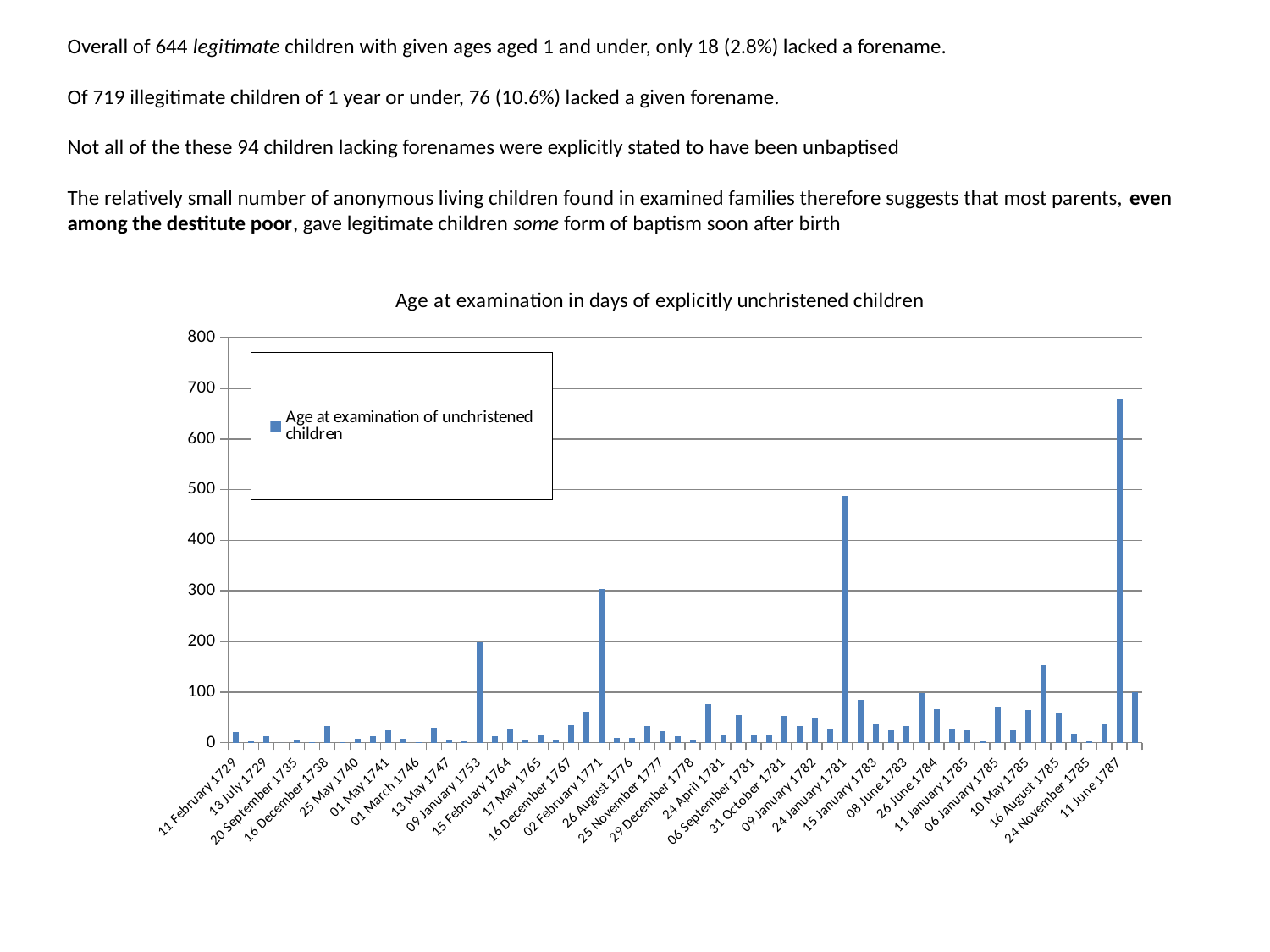
Is the value of the tallest bar in the chart greater or less than 600? greater What is the title of the chart? Age at examination in days of explicitly unchristened children Is the value for 02 February 1771 greater or less than 200? greater What kind of chart is shown on the slide? bar chart Is the value for 24 January 1781 greater or less than 700? less Which is larger, the value for 24 January 1781 or the value for 02 February 1771? 24 January 1781 How many series does the chart's legend list? 1 What is the highest value shown on the chart's vertical axis? 800 What is the legend entry shown in the chart? Age at examination of unchristened children